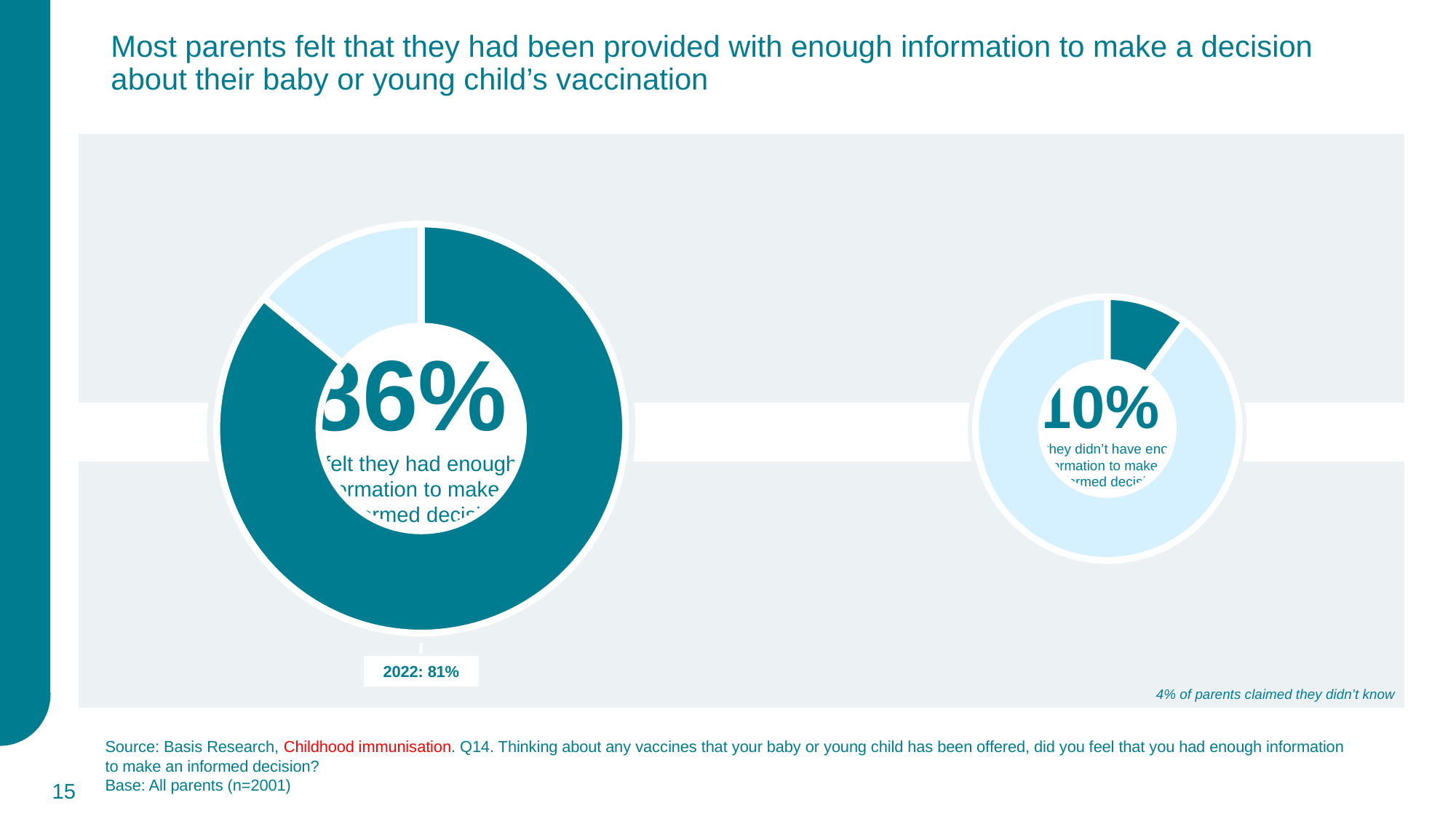
What is the base (sample size) stated for the charts on this slide? All parents (n=2001) How many pie charts are shown on the slide? 2 In the right-hand chart, what percentage of parents felt they didn't have enough information to make an informed decision? 10% In the left-hand chart, is the share of parents who felt they had enough information greater or less than 75%? greater What was the 2022 figure shown beneath the left-hand chart for parents who felt they had enough information? 2022: 81% What percentage of parents claimed they didn't know, according to the note at the bottom right of the chart area? 4% Which is larger: the share of parents who felt they had enough information (left chart) or the share who felt they didn't (right chart)? Felt they had enough information (left chart) In the left-hand chart, is the share of parents who felt they had enough information greater or less than 50%? greater In the right-hand chart, is the dark teal slice greater or less than 25% of the pie? less What kind of chart is used on this slide to show the share of parents who felt they had enough information? Pie chart (donut) What colour is the largest slice in the left-hand chart? Dark teal